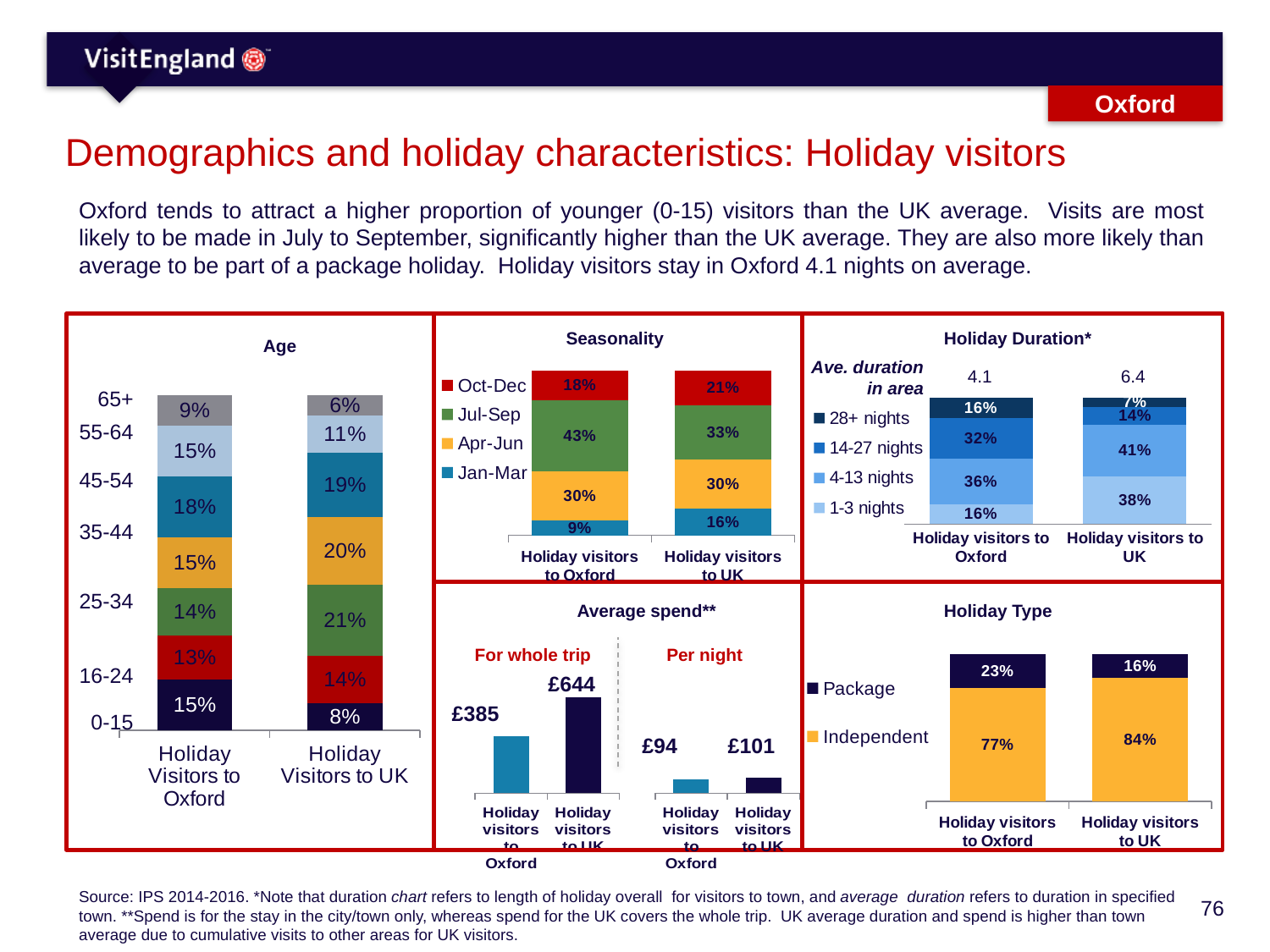
In the Age chart, what percentage of holiday visitors to Oxford are aged 0-15? 15% How many series does the legend of the Seasonality chart list? 4 In the Holiday Type chart, what percentage of holiday visitors to Oxford are on a package holiday? 23% In the Seasonality chart, what percentage of holiday visitors to Oxford visit in Jul-Sep? 43% What kind of chart is the Holiday Type chart? Stacked bar chart In the Age chart, which age group has the largest share among holiday visitors to UK? 25-34 In the Holiday Duration chart, what is the average duration in area for holiday visitors to Oxford? 4.1 In the Seasonality chart, which is larger: the Jan-Mar share for holiday visitors to Oxford or for holiday visitors to UK? Holiday visitors to UK In the Average spend chart, what is the difference in per night spend between holiday visitors to UK and holiday visitors to Oxford? £7 In the Holiday Duration chart, what percentage of holiday visitors to UK stay 1-3 nights? 38% In the Age chart, what is the difference between the 65+ share for holiday visitors to Oxford and for holiday visitors to UK? 3% In the Average spend chart, what is the spend for the whole trip for holiday visitors to UK? £644